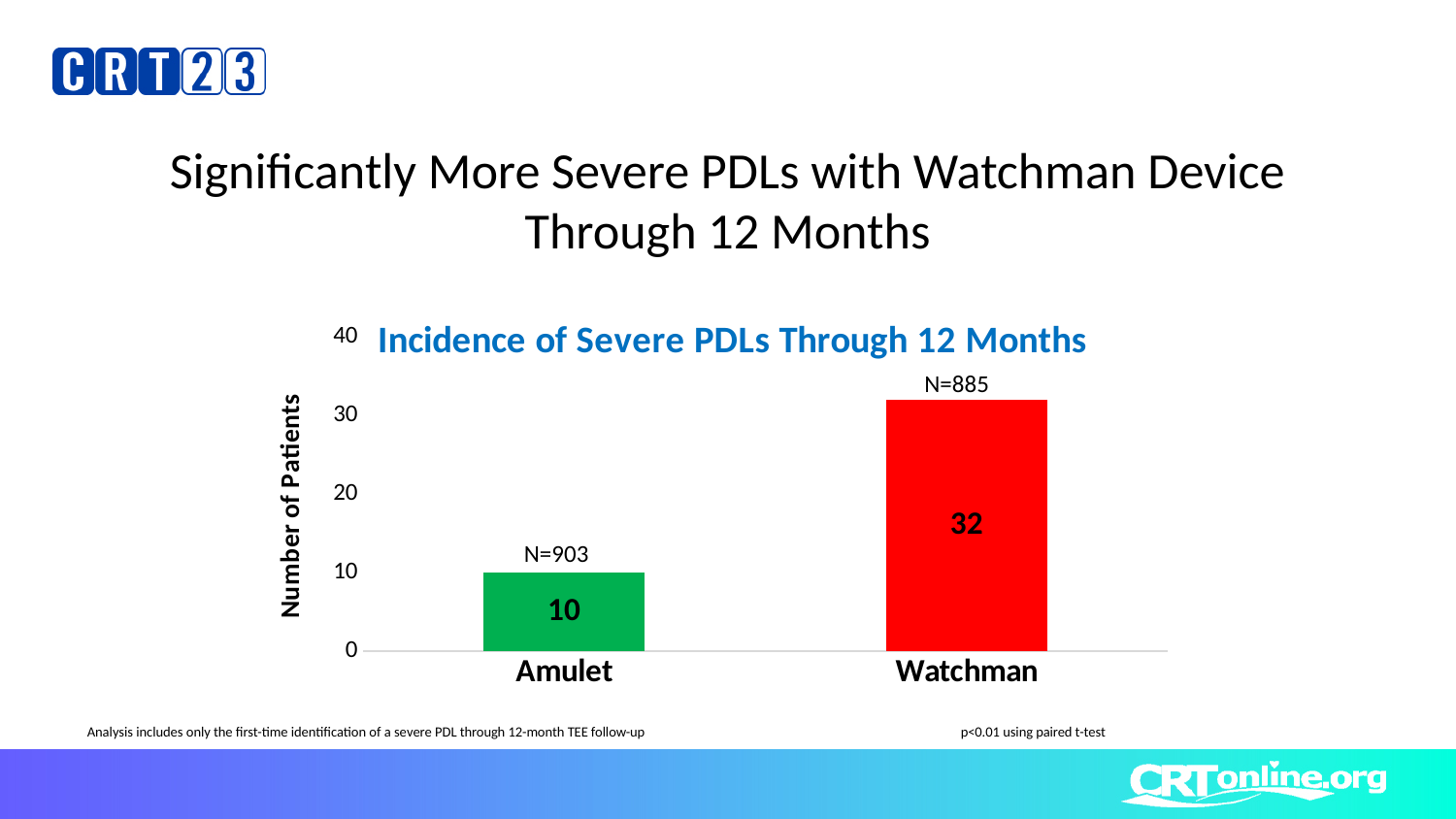
Is the value for Watchman greater or less than 20? greater What is the number of patients with severe PDLs for Amulet? 10 What is the number of patients with severe PDLs for Watchman? 32 Which device has the lower number of patients with severe PDLs? Amulet Which device has the higher number of patients with severe PDLs? Watchman What is the y-axis label of the chart? Number of Patients What kind of chart is shown on the slide? Bar chart What is the title of the chart? Incidence of Severe PDLs Through 12 Months What is the N value shown above the Amulet bar? N=903 How many categories are shown on the x axis? 2 What is the N value shown above the Watchman bar? N=885 What is the difference in number of patients between Watchman and Amulet? 22